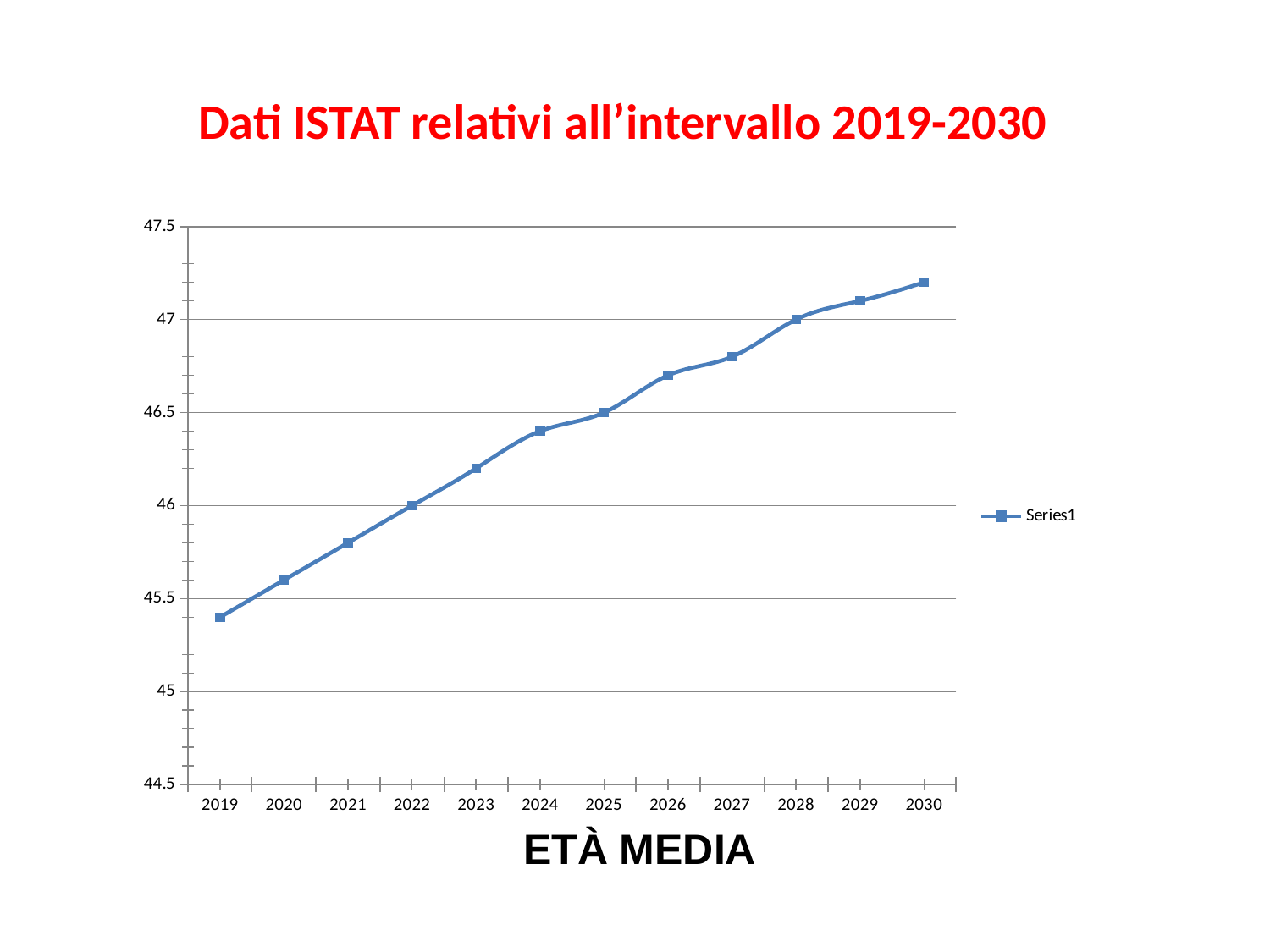
Which year has the lowest value? 2019 What kind of chart is shown on the slide? line chart What is the title of the slide? Dati ISTAT relativi all'intervallo 2019-2030 Is the value for 2030 greater or less than 47? greater Is the value for 2019 greater or less than 45.5? less How many years are plotted on the x axis? 12 Which year has the highest value? 2030 How many series does the legend list? 1 Do the values rise or fall from 2019 to 2030? rise What is the value for 2025? 46.5 What is the value for 2028? 47 What is the value for 2022? 46